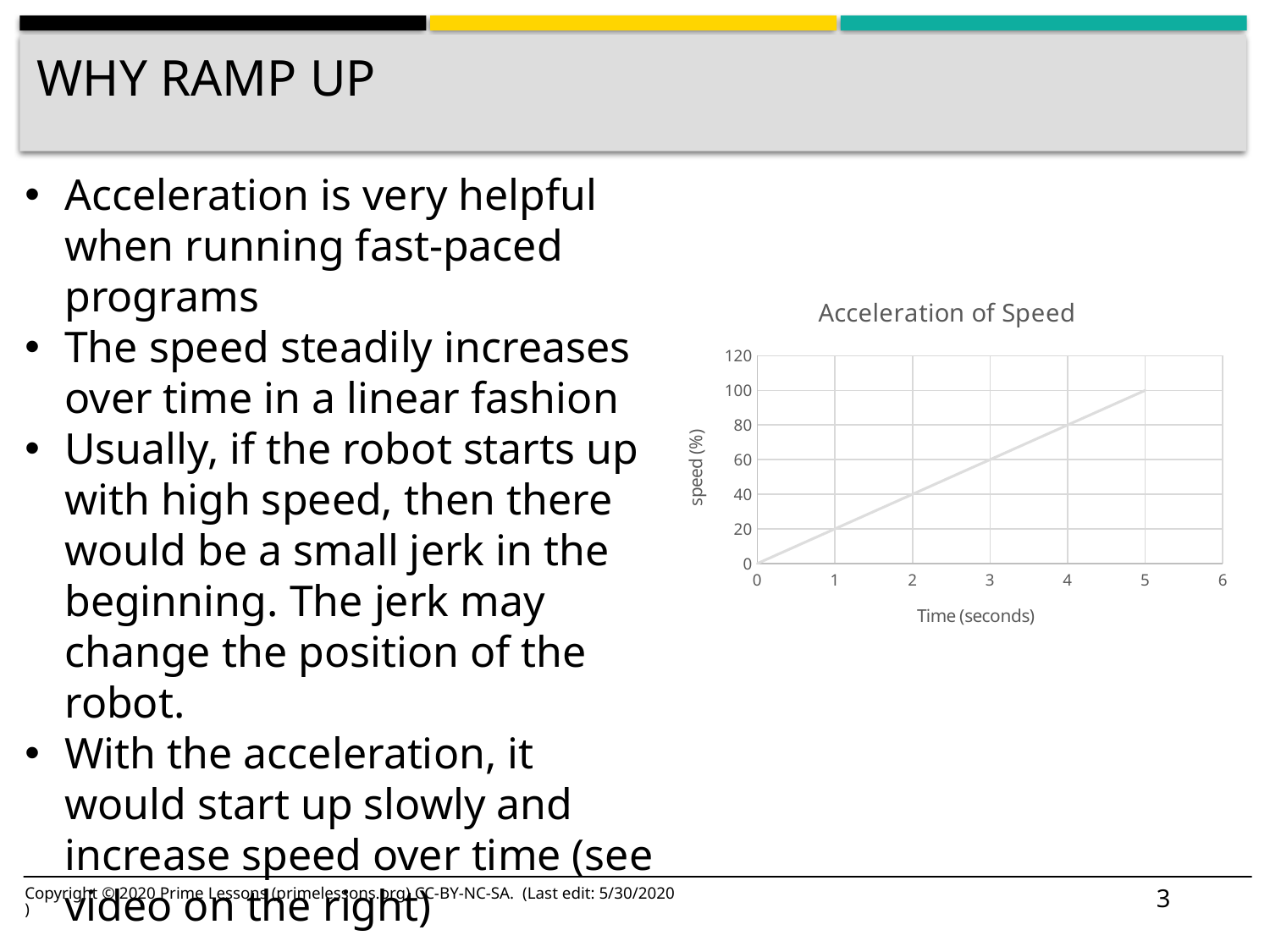
At which time shown does the line reach its highest speed? 5 Is the speed at 4 seconds greater or less than 60? greater What is the label of the x axis of the chart? Time (seconds) What is the speed (%) at 3 seconds? 60 What is the speed (%) at 0 seconds? 0 What is the difference in speed (%) between 5 seconds and 1 second? 80 What kind of chart is shown on the slide? line chart What is the speed (%) at 5 seconds? 100 What is the title of the chart? Acceleration of Speed Does the speed rise or fall as time increases along the x axis? rise What is the speed (%) at 1 second? 20 Which is larger, the speed at 4 seconds or the speed at 2 seconds? 4 seconds